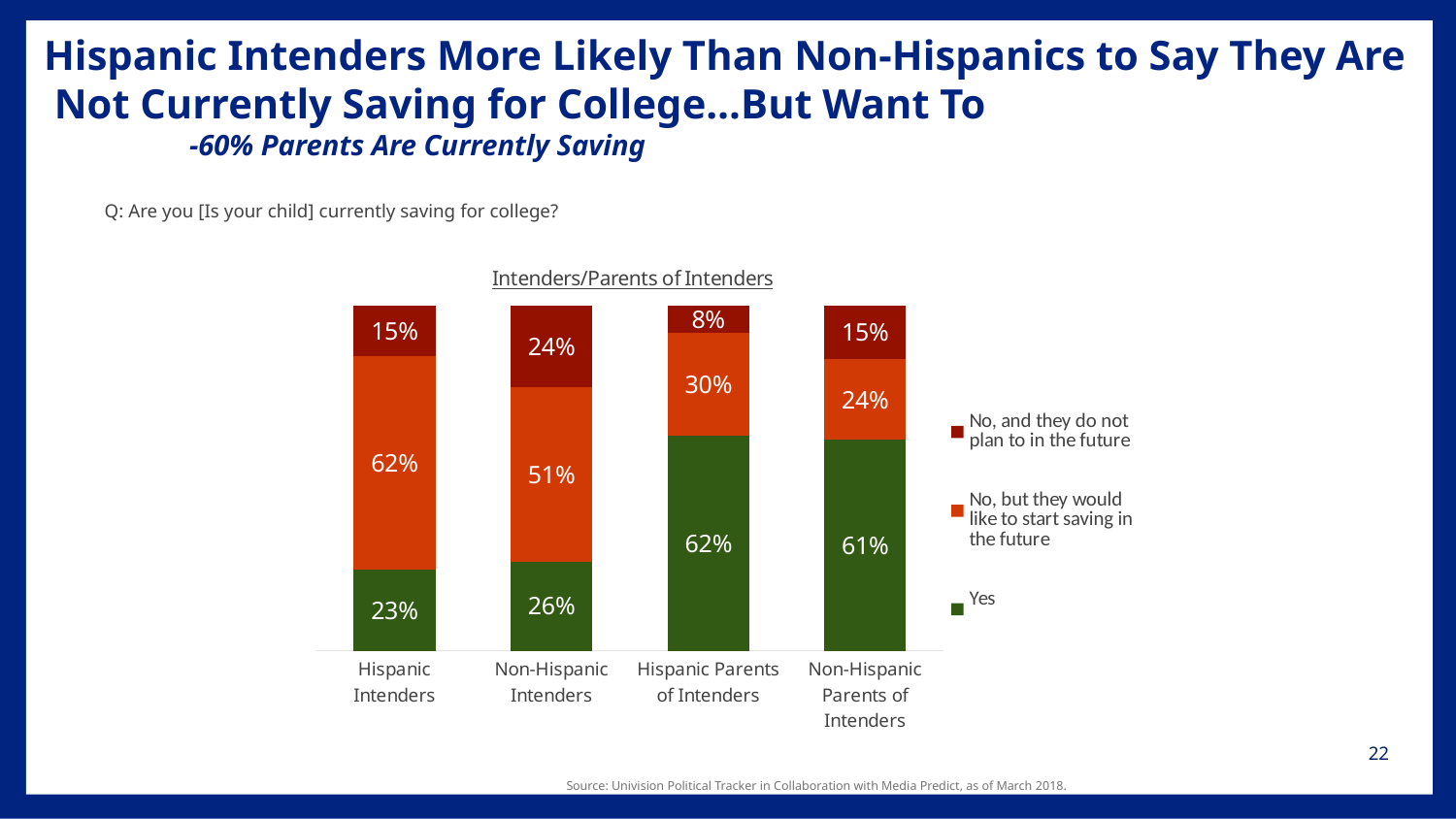
Which category has the highest "No, and they do not plan to in the future" percentage? Non-Hispanic Intenders What percentage of Non-Hispanic Intenders said "No, and they do not plan to in the future"? 24% What percentage of Hispanic Intenders answered "Yes" to currently saving for college? 23% Which category has the lowest "Yes" percentage? Hispanic Intenders What kind of chart is shown on the slide? Stacked bar chart What is the title shown above the chart? Intenders/Parents of Intenders What is the difference between the "No, but they would like to start saving in the future" percentages for Hispanic Intenders and Non-Hispanic Intenders? 11 percentage points What percentage of Hispanic Parents of Intenders said "No, but they would like to start saving in the future"? 30% What percentage of Non-Hispanic Parents of Intenders answered "Yes"? 61% How many categories are shown on the x axis of the chart? 4 Which is larger: the "Yes" percentage for Hispanic Parents of Intenders or for Non-Hispanic Parents of Intenders? Hispanic Parents of Intenders How many series does the legend list? 3